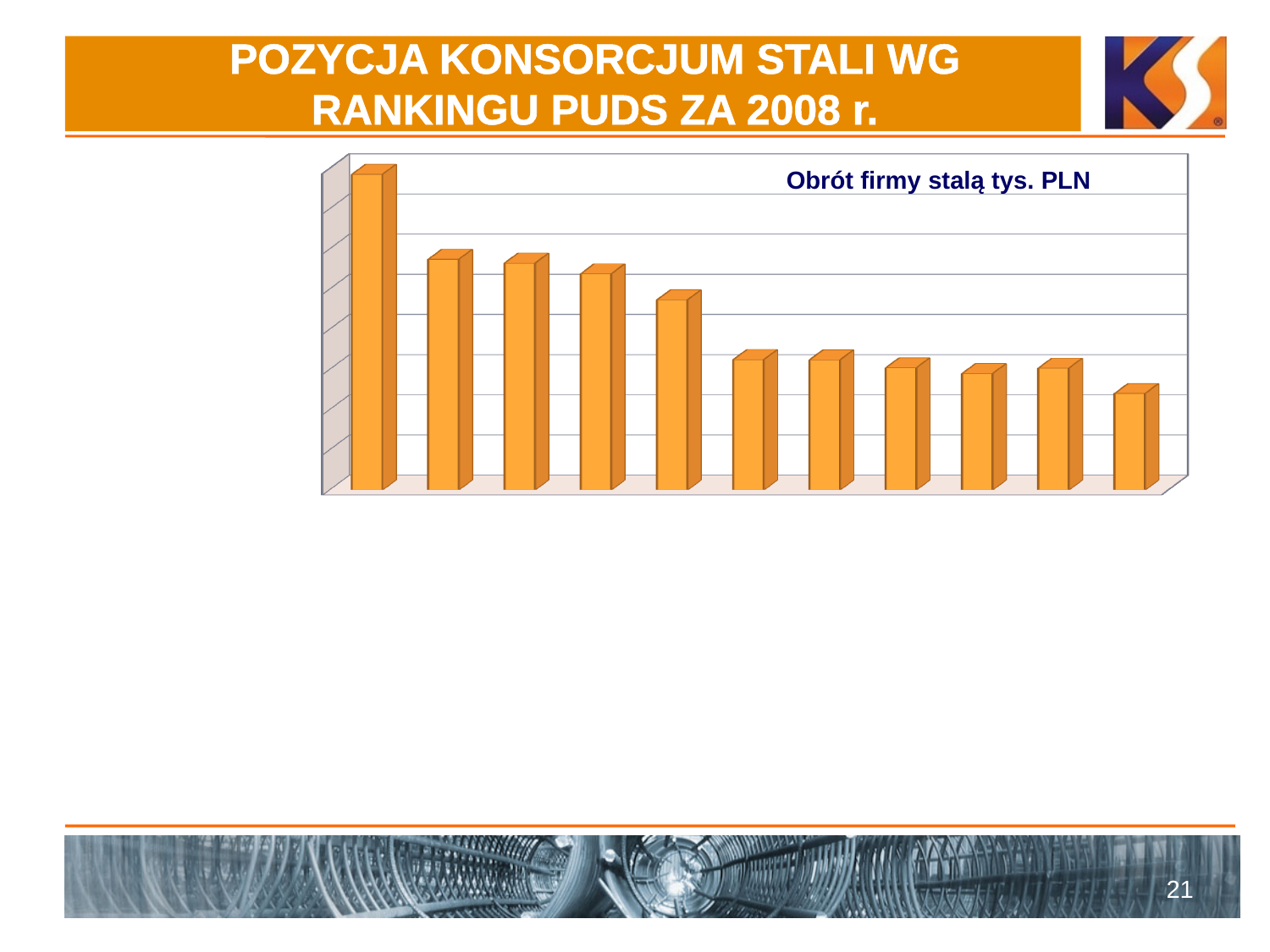
Which is larger, the fifth bar from the left or the sixth bar from the left? the fifth bar Which bar in the chart is the shortest? the last (rightmost) bar Which bar in the chart is the tallest? the first (leftmost) bar Which is larger, the leftmost bar or the rightmost bar? the leftmost bar What is the title shown inside the chart area? Obrót firmy stalą tys. PLN How many bars does the chart contain? 11 Do the bar values generally rise or fall from left to right across the chart? fall What colour are the bars in the chart? orange What kind of chart is shown on the slide? bar chart